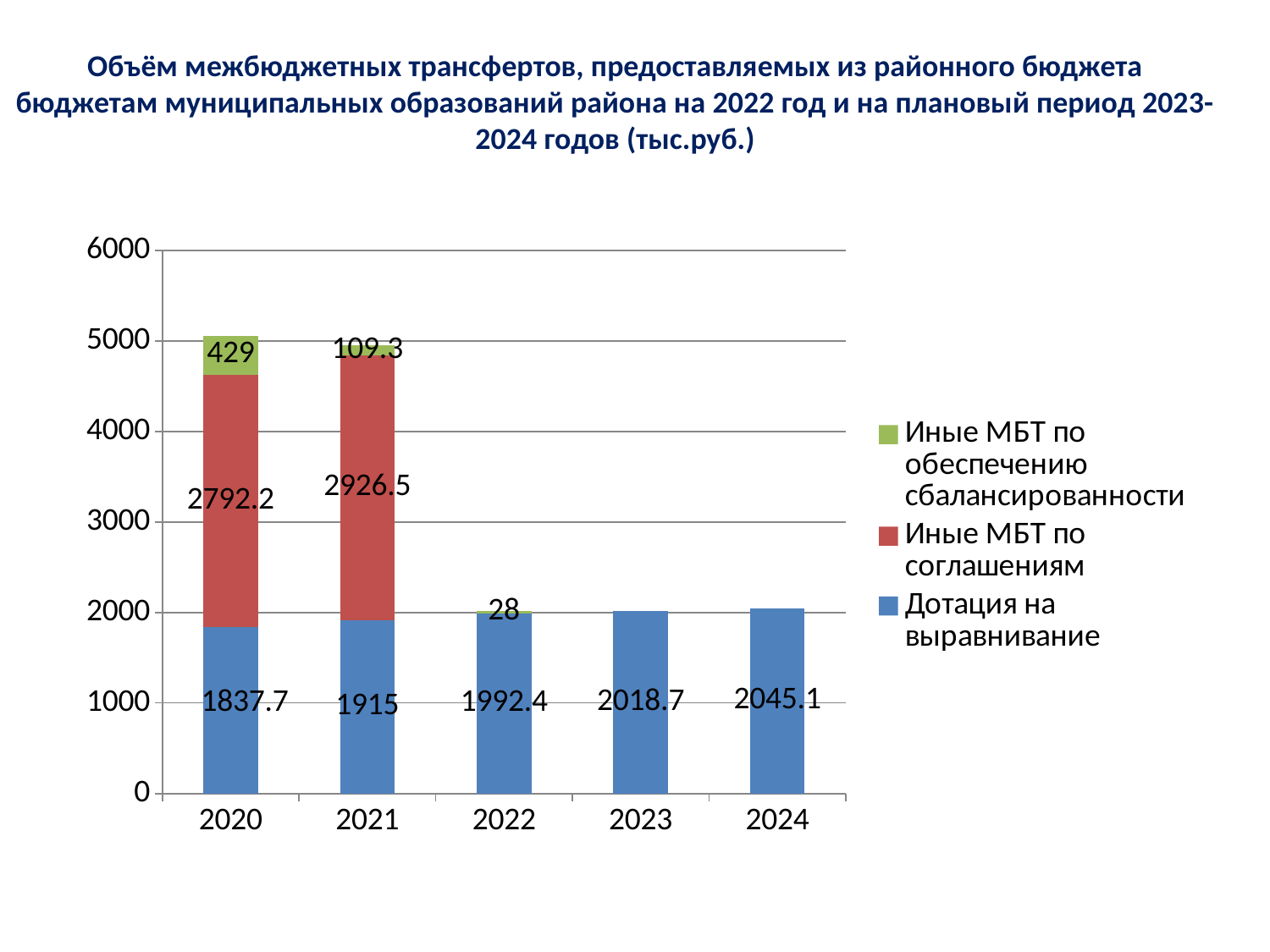
What type of chart is shown on the slide? stacked bar chart Does the value of "Дотация на выравнивание" rise or fall from 2020 to 2024? rise What is the value of "Дотация на выравнивание" for 2022? 1992.4 How many series does the legend list? 3 Which year has the lowest value for "Дотация на выравнивание"? 2020 Which year has the highest value for "Дотация на выравнивание"? 2024 Which is larger: "Иные МБТ по соглашениям" in 2020 or in 2021? 2021 What is the difference between the "Дотация на выравнивание" values for 2024 and 2020? 207.4 How many years are shown on the x axis? 5 What is the value of "Иные МБТ по соглашениям" for 2021? 2926.5 What is the total of the stacked bar for 2022? 2020.4 What is the value of "Иные МБТ по обеспечению сбалансированности" for 2020? 429